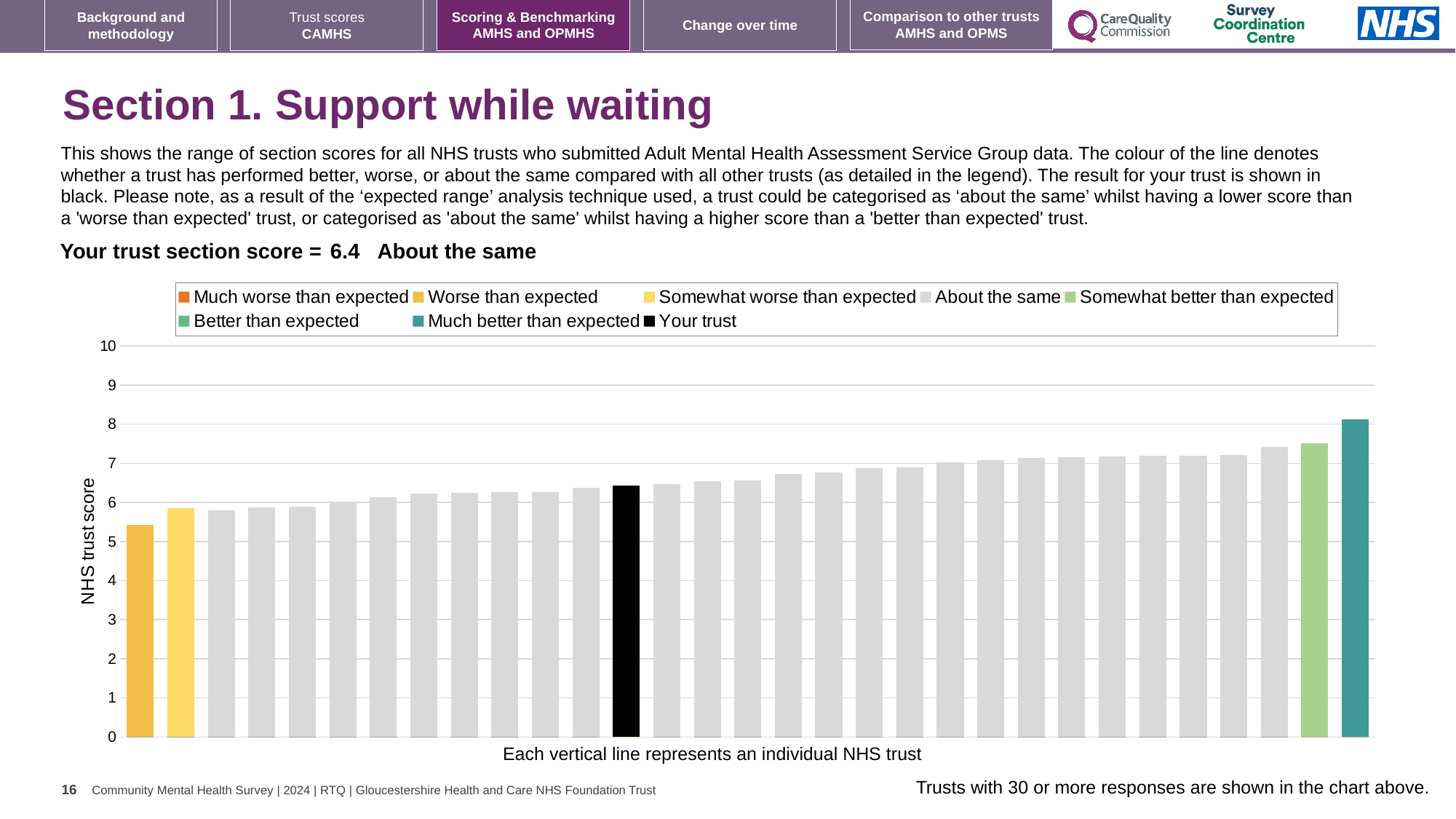
Which legend category does the tallest bar belong to? Much better than expected Is the value of the black bar (your trust) greater or less than 6? greater How many entries does the chart legend list? 8 What is the label on the vertical axis of the chart? NHS trust score Is the value of the leftmost bar greater or less than 6? less Which is taller, the black bar for your trust or the leftmost bar? the black bar for your trust Do the bar values rise or fall from left to right across the chart? rise Which category does your trust fall into according to the slide? About the same Is the value of the rightmost bar greater or less than 7? greater How many bars are coloured as 'Much better than expected'? 1 What is the section score for your trust shown on the slide? 6.4 What kind of chart is shown on the slide? bar chart